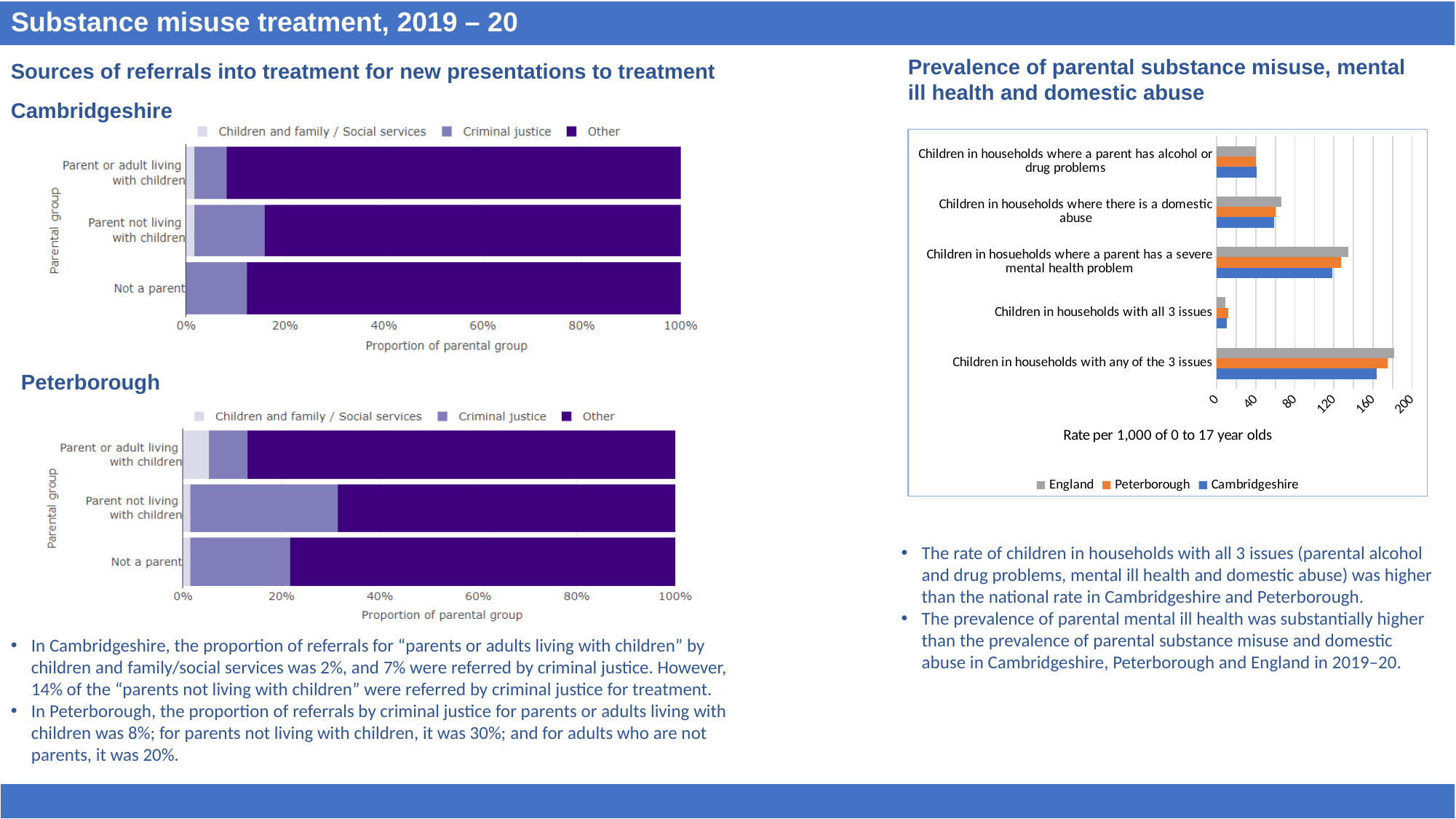
What is the x-axis label of the 'Prevalence of parental substance misuse, mental ill health and domestic abuse' chart? Rate per 1,000 of 0 to 17 year olds In the 'Prevalence of parental substance misuse, mental ill health and domestic abuse' chart, which category has the lowest rates? Children in households with all 3 issues How many series does the legend of the 'Prevalence of parental substance misuse, mental ill health and domestic abuse' chart list? 3 How many categories are shown in the 'Prevalence of parental substance misuse, mental ill health and domestic abuse' chart? 5 In the Cambridgeshire chart, which parental group has the largest Criminal justice segment? Parent not living with children In the Peterborough chart, which parental group has the larger Criminal justice segment: 'Parent not living with children' or 'Parent or adult living with children'? Parent not living with children In the 'Prevalence of parental substance misuse, mental ill health and domestic abuse' chart, is the England rate for 'Children in households where a parent has a severe mental health problem' greater or less than 120? greater In the Peterborough chart, is the cumulative proportion covered by Children and family / Social services plus Criminal justice for 'Parent not living with children' greater or less than 20%? greater What type of chart is the Cambridgeshire chart on the left? Bar chart How many series does the legend of the Cambridgeshire chart list? 3 How many parental groups are shown in the Peterborough chart? 3 In the 'Prevalence of parental substance misuse, mental ill health and domestic abuse' chart, which category has the highest rates? Children in households with any of the 3 issues